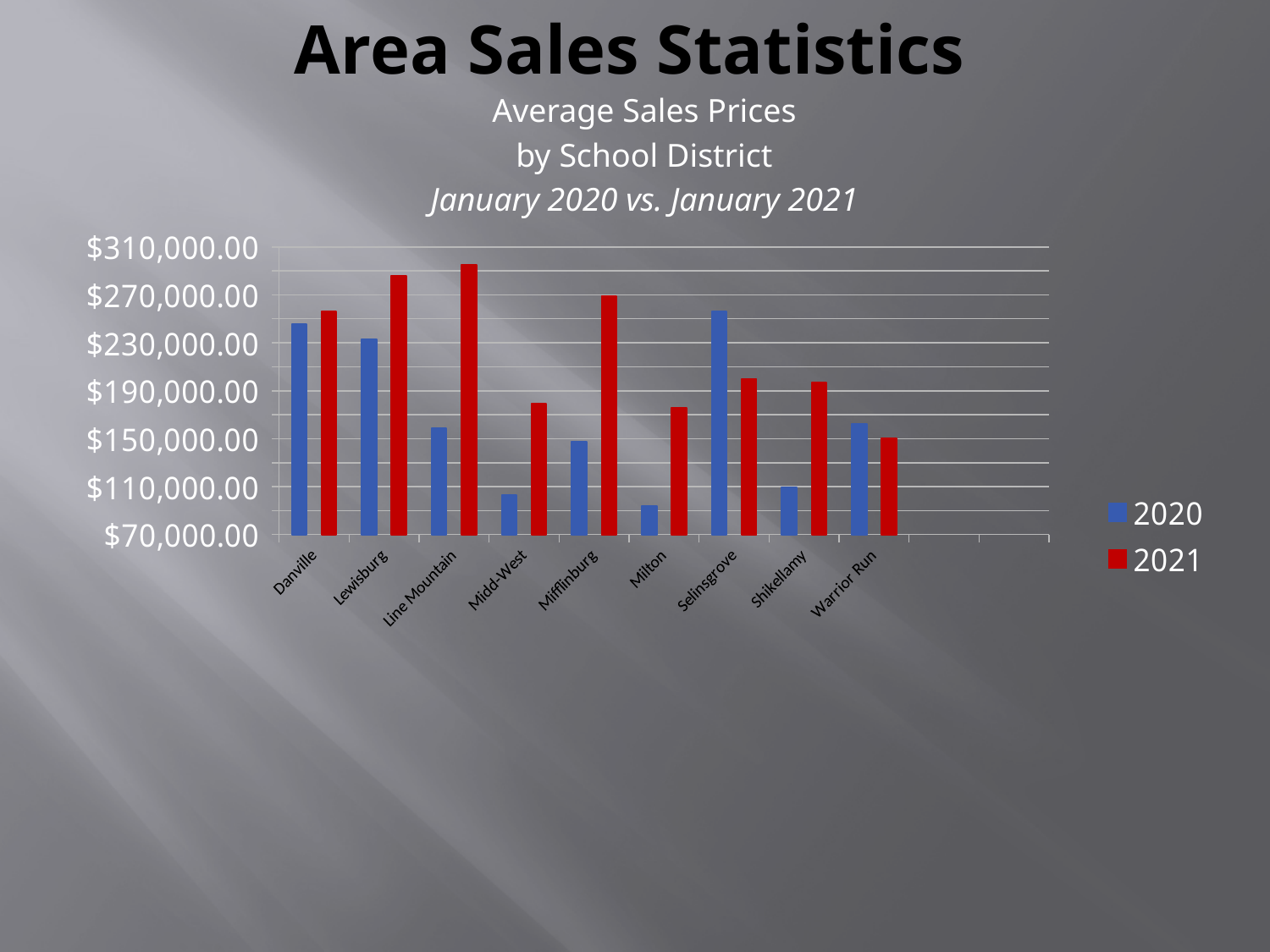
Which school district has the lowest 2020 average sales price? Milton Is the 2021 value for Shikellamy greater or less than $190,000.00? greater How many series does the chart's legend list? 2 Is the 2020 value for Midd-West greater or less than $110,000.00? less Which colour represents the 2021 series in the chart? Red How many school districts are shown on the x axis of the chart? 9 What kind of chart is shown on the slide? Bar chart For Selinsgrove, which year has the higher average sales price, 2020 or 2021? 2020 Which school district has the highest 2021 average sales price? Line Mountain For Mifflinburg, which year has the higher average sales price, 2020 or 2021? 2021 Is the 2021 value for Line Mountain greater or less than $270,000.00? greater Which school district has the highest 2020 average sales price? Selinsgrove